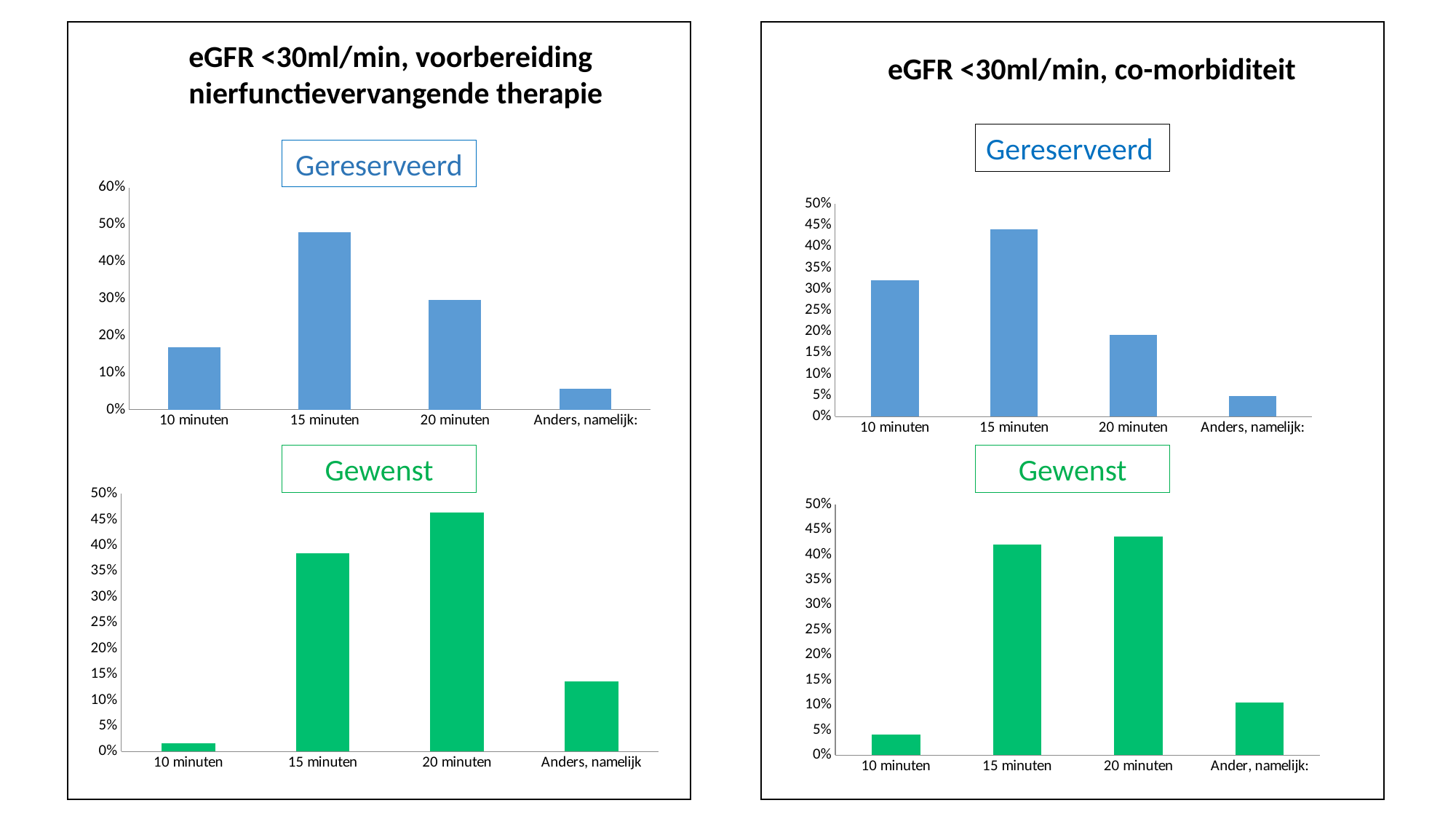
In the 'Gereserveerd' chart under 'eGFR <30ml/min, co-morbiditeit', which category has the highest value? 15 minuten In the 'Gereserveerd' chart under 'eGFR <30ml/min, voorbereiding nierfunctievervangende therapie', is the value for 15 minuten greater or less than 40%? greater In the 'Gewenst' chart under 'eGFR <30ml/min, voorbereiding nierfunctievervangende therapie', is the value for Anders, namelijk greater or less than 10%? greater In the 'Gereserveerd' chart under 'eGFR <30ml/min, voorbereiding nierfunctievervangende therapie', which category has the lowest value? Anders, namelijk: In the 'Gereserveerd' chart under 'eGFR <30ml/min, voorbereiding nierfunctievervangende therapie', which category has the highest value? 15 minuten In the 'Gewenst' chart under 'eGFR <30ml/min, co-morbiditeit', which category has the lowest value? 10 minuten In the 'Gewenst' chart under 'eGFR <30ml/min, voorbereiding nierfunctievervangende therapie', which category has the lowest value? 10 minuten In the 'Gereserveerd' chart under 'eGFR <30ml/min, co-morbiditeit', is the value for 10 minuten greater or less than 30%? greater In the 'Gereserveerd' chart under 'eGFR <30ml/min, co-morbiditeit', which is larger, the value for 10 minuten or the value for 20 minuten? 10 minuten In the 'Gewenst' chart under 'eGFR <30ml/min, voorbereiding nierfunctievervangende therapie', which category has the highest value? 20 minuten How many categories are shown on the x axis of the 'Gewenst' chart under 'eGFR <30ml/min, co-morbiditeit'? 4